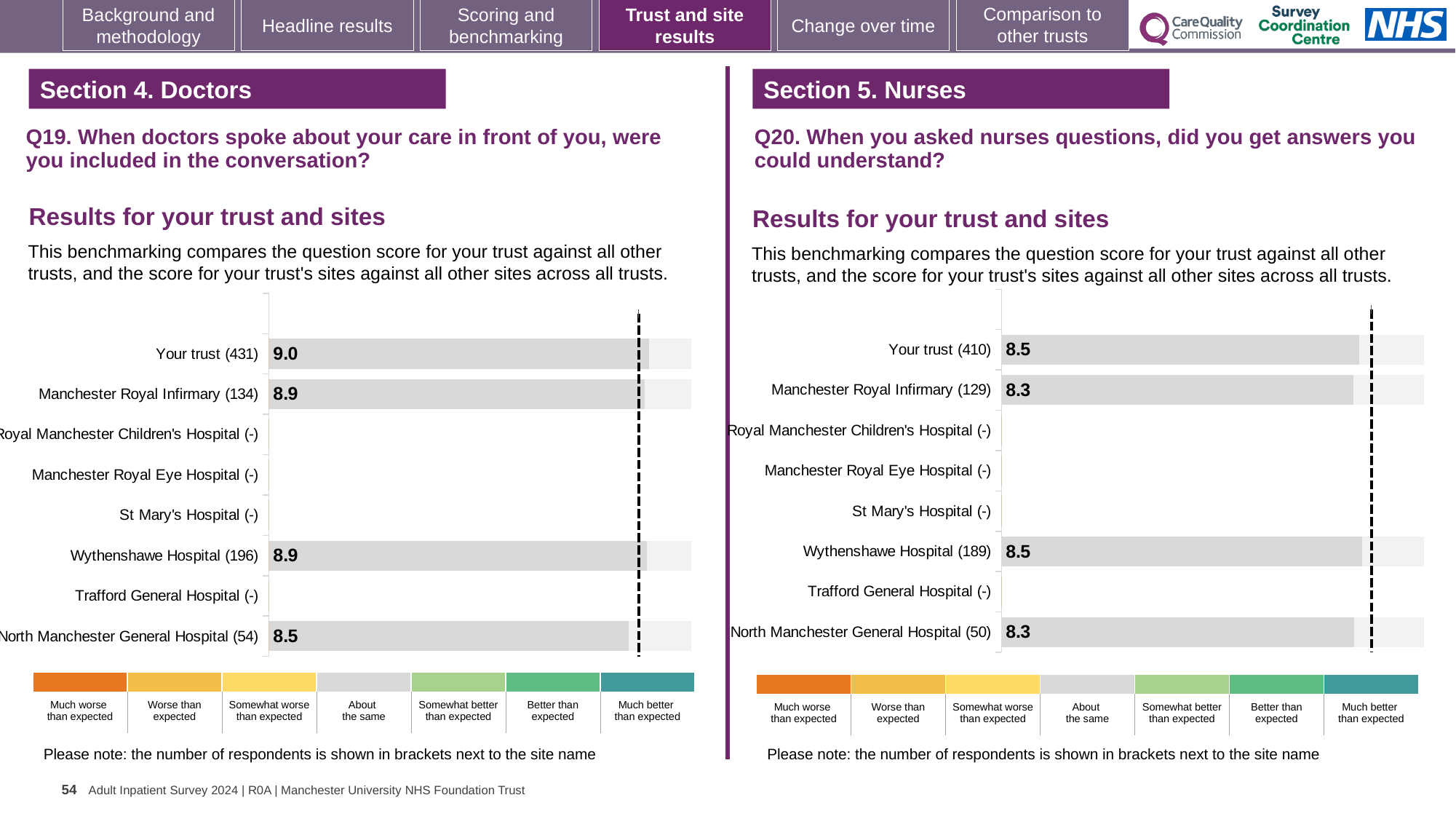
In the Q20 chart on the right, what is the difference between the score for Your trust and the score for North Manchester General Hospital? 0.2 In the Q19 chart on the left, which site has the lowest score? North Manchester General Hospital In the Q20 chart on the right, what is the score for Wythenshawe Hospital? 8.5 In the Q19 chart on the left, what is the score for North Manchester General Hospital? 8.5 In the Q19 chart on the left, what is the score for Wythenshawe Hospital? 8.9 In the Q20 chart on the right, what is the score for Manchester Royal Infirmary? 8.3 In the Q19 chart on the left, what is the difference between the score for Your trust and the score for North Manchester General Hospital? 0.5 How many site rows (including Your trust) are listed in the Q19 chart on the left? 8 What kind of chart is the Q20 chart on the right? Bar chart How many respondents are shown in brackets for Your trust in the Q20 chart on the right? 410 In the Q20 chart on the right, which is larger: the score for Wythenshawe Hospital or the score for Manchester Royal Infirmary? Wythenshawe Hospital In the Q19 chart on the left, what is the score for Your trust? 9.0